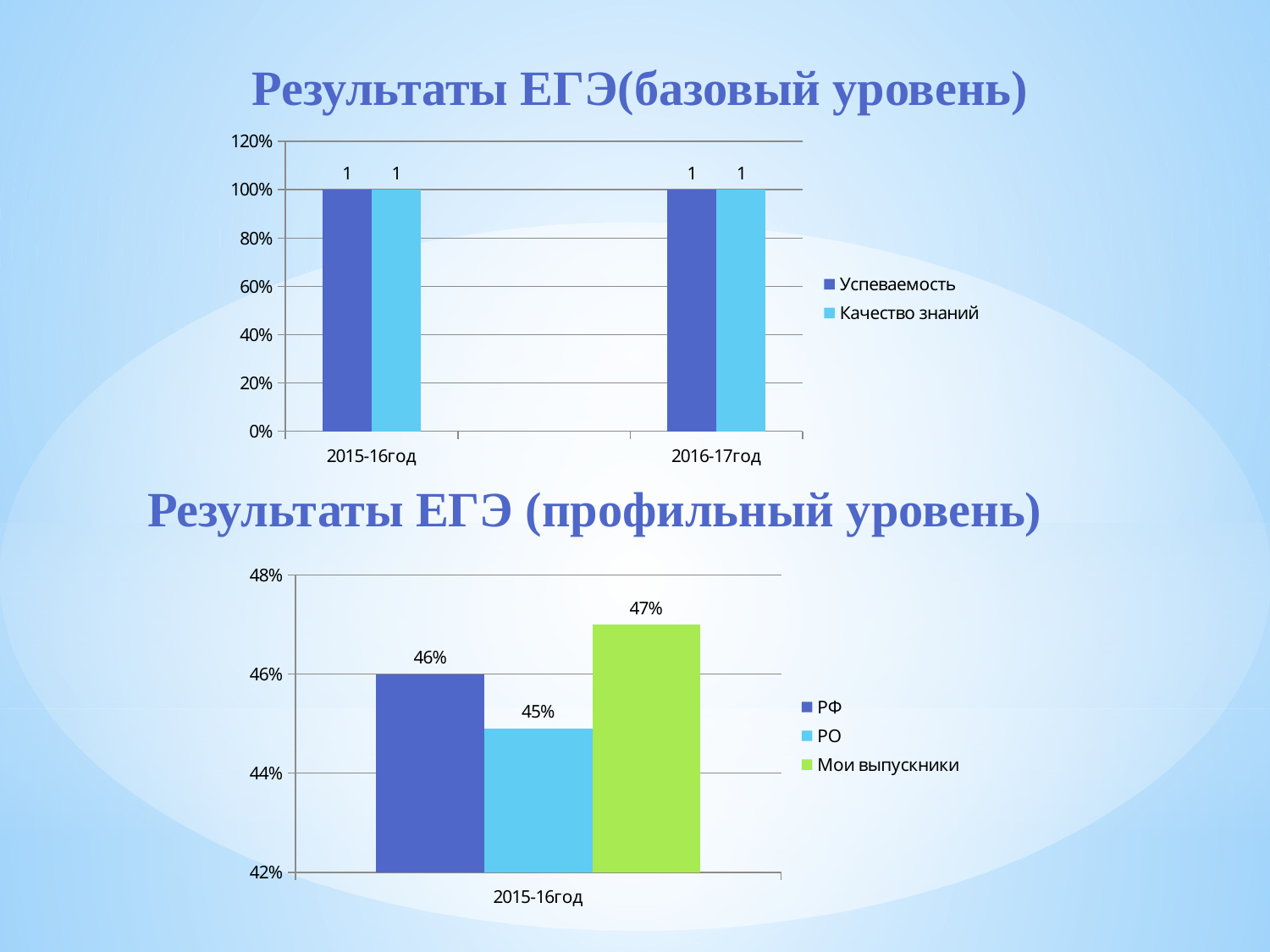
In the chart titled 'Результаты ЕГЭ (профильный уровень)', what is the difference between the values for Мои выпускники and РО? 2% In the chart titled 'Результаты ЕГЭ(базовый уровень)', what is the data label shown for Успеваемость in 2015-16год? 1 In the chart titled 'Результаты ЕГЭ (профильный уровень)', what is the value for Мои выпускники? 47% In the chart titled 'Результаты ЕГЭ(базовый уровень)', how many categories are shown on the x axis? 2 In the chart titled 'Результаты ЕГЭ (профильный уровень)', what is the value for РФ? 46% In the chart titled 'Результаты ЕГЭ (профильный уровень)', which series has the lowest value? РО In the chart titled 'Результаты ЕГЭ(базовый уровень)', what is the second legend entry? Качество знаний In the chart titled 'Результаты ЕГЭ (профильный уровень)', what is the value for РО? 45% What kind of chart is the top chart, 'Результаты ЕГЭ(базовый уровень)'? Bar chart In the chart titled 'Результаты ЕГЭ (профильный уровень)', how many series does the legend list? 3 In the chart titled 'Результаты ЕГЭ(базовый уровень)', how many series does the legend list? 2 In the chart titled 'Результаты ЕГЭ (профильный уровень)', which series has the highest value? Мои выпускники